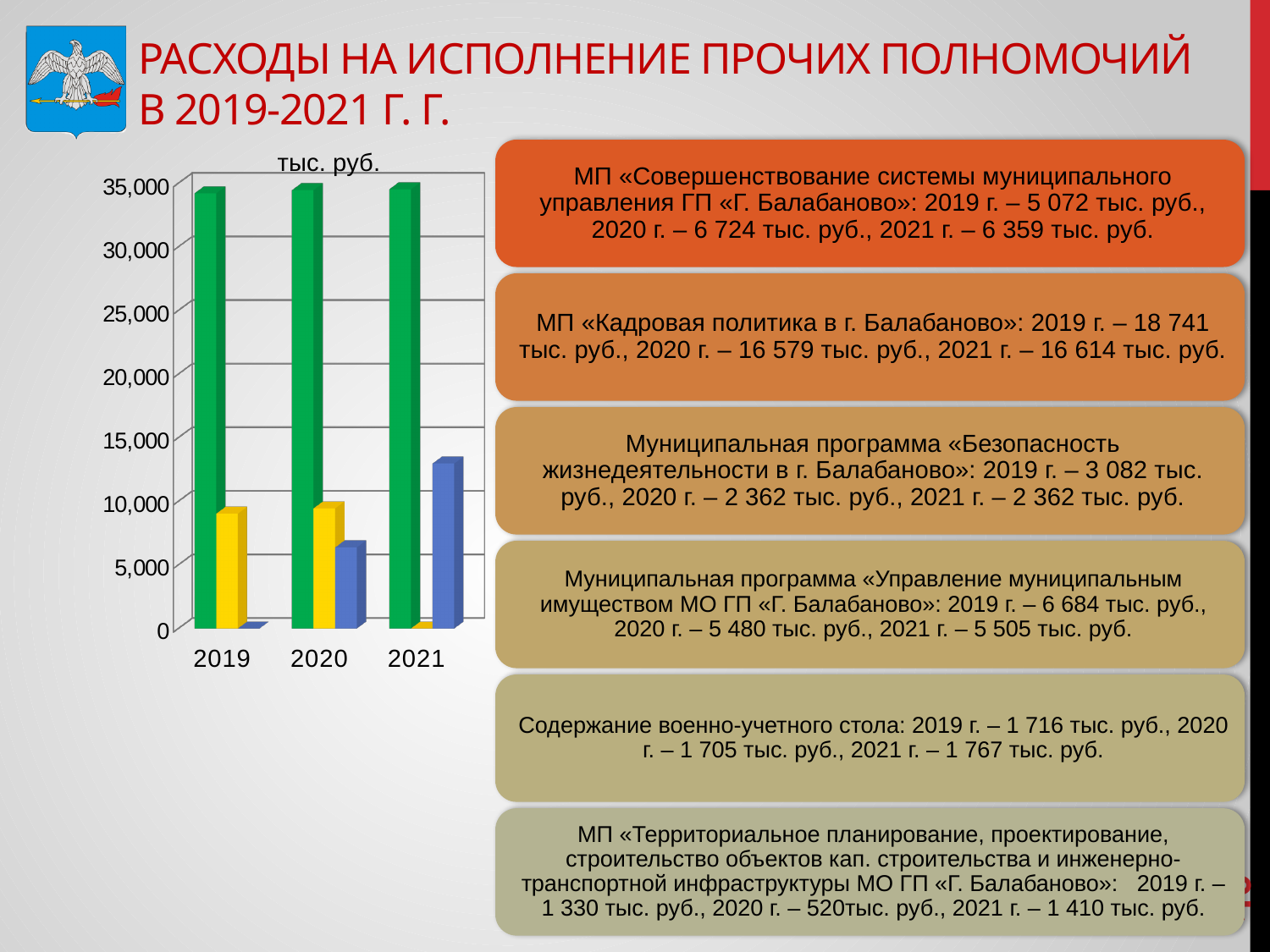
How many years (categories) are shown on the x axis of the chart? 3 What kind of chart is shown on the slide? bar chart Which bar colour has the highest value in 2020? green Is the value of the blue bar for 2021 greater or less than 10,000? greater What is the title shown above the chart? тыс. руб. Does the blue series rise or fall from 2019 to 2021? rises Is the value of the green bar for 2019 greater or less than 30,000? greater Which bar colour has the lowest value in 2021? yellow Is the value of the blue bar for 2020 greater or less than 10,000? less How many data series (bar colours) are plotted in the chart? 3 In 2020, which is larger: the yellow bar or the blue bar? the yellow bar